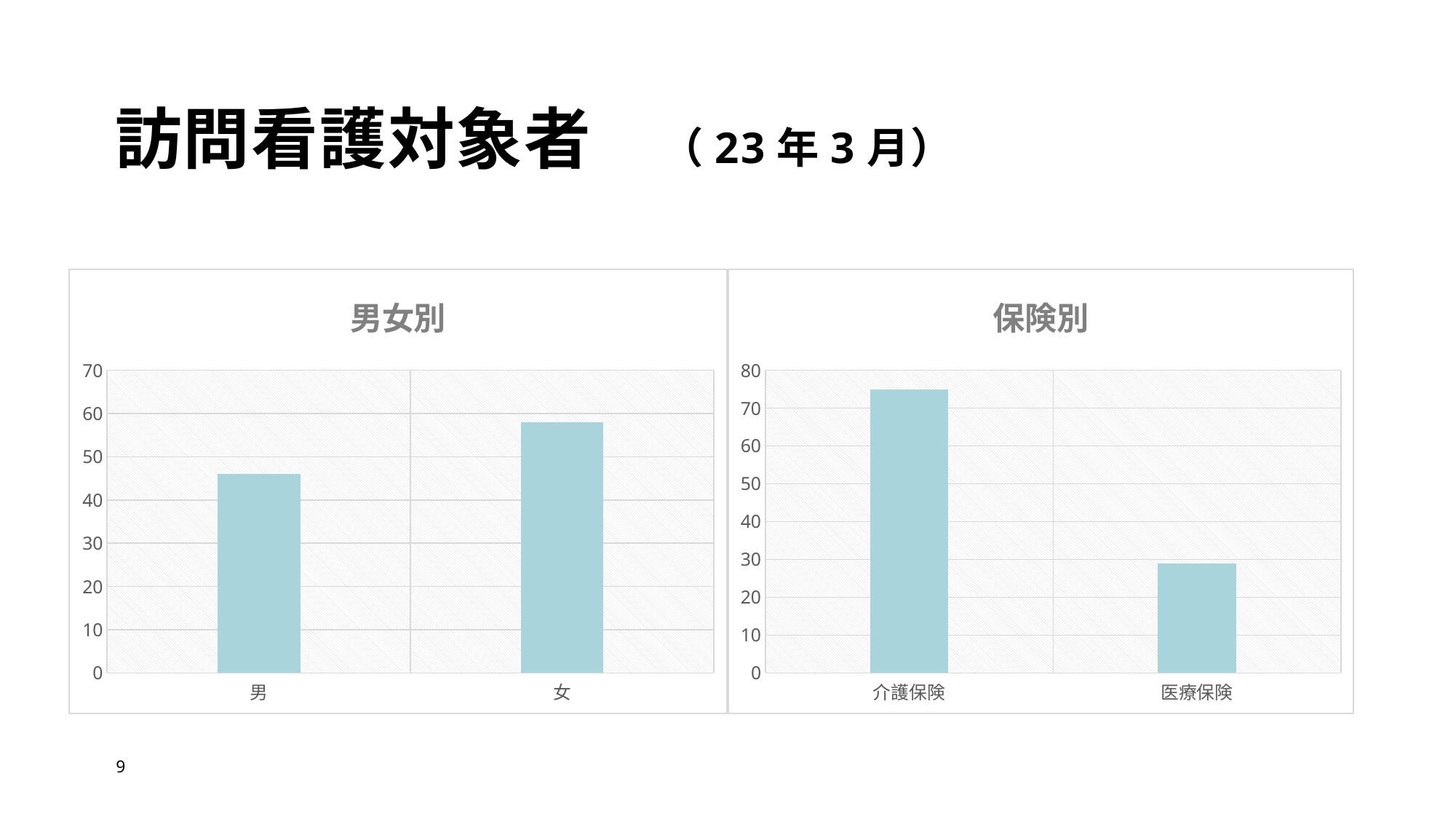
What kind of chart is the 男女別 chart? bar chart What is the title of the chart on the right side of the slide? 保険別 In the 保険別 chart, is the value for 介護保険 greater or less than 70? greater In the 男女別 chart, is the value for 男 greater or less than 40? greater In the 保険別 chart, which category has the lowest value? 医療保険 In the 保険別 chart, which is larger, 介護保険 or 医療保険? 介護保険 In the 男女別 chart, which category has the lower value? 男 In the 男女別 chart, is the value for 女 greater or less than 60? less In the 保険別 chart, which category has the highest value? 介護保険 In the 男女別 chart, which category has the higher value? 女 In the 男女別 chart, how many categories are shown on the x axis? 2